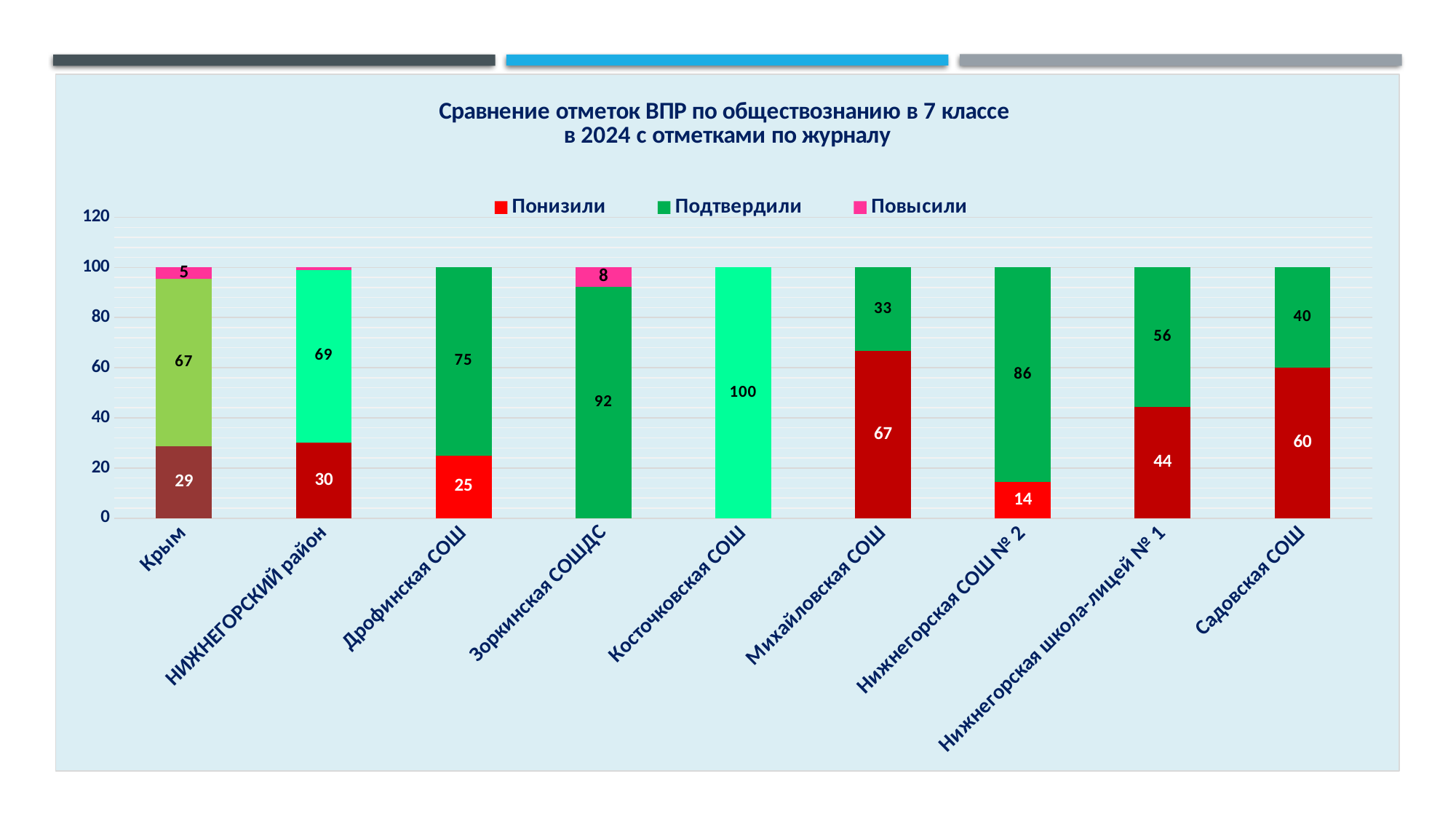
What type of chart is shown on the slide? stacked bar chart How many series does the legend list? 3 Which category has the lowest non-zero value for "Понизили"? Нижнегорская СОШ № 2 Which is larger: the "Подтвердили" value for Дрофинская СОШ or for Нижнегорская школа-лицей № 1? Дрофинская СОШ What is the value of "Подтвердили" for Косточковская СОШ? 100 What is the difference between the "Понизили" values for Садовская СОШ and Нижнегорская школа-лицей № 1? 16 What is the title of the chart? Сравнение отметок ВПР по обществознанию в 7 классе в 2024 с отметками по журналу Which category has the highest value for "Понизили"? Михайловская СОШ How many categories are shown on the x axis? 9 What is the value of "Подтвердили" for Нижнегорская СОШ № 2? 86 What is the value of "Повысили" for Зоркинская СОШДС? 8 What is the value of "Понизили" for Михайловская СОШ? 67